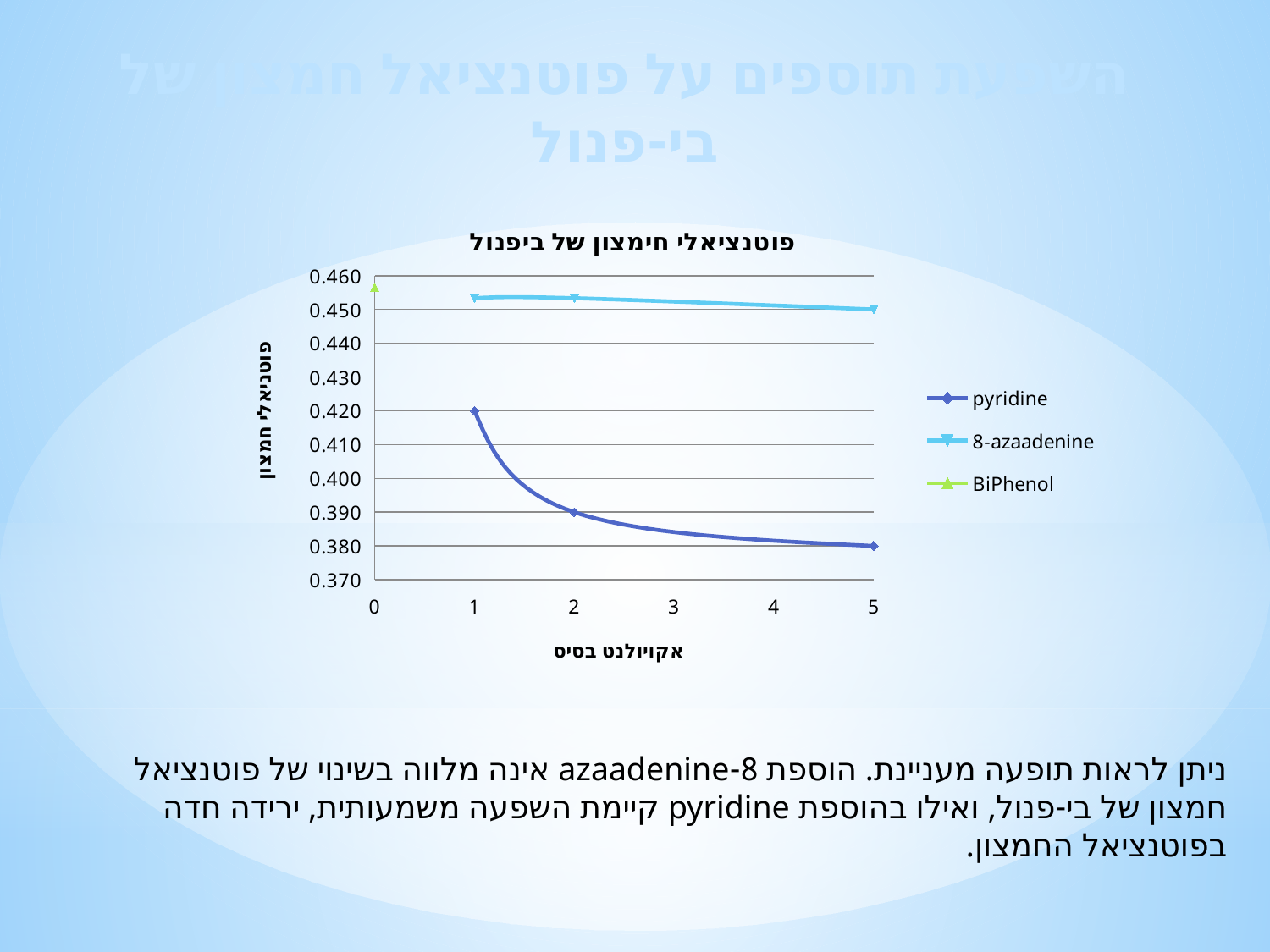
What kind of chart is shown on the slide? line chart What is the value of the pyridine series at x = 5? 0.380 What is the label of the x axis? אקויולנט בסיס Does the pyridine series rise or fall as x increases? fall Is the value of the pyridine series at x = 5 greater or less than 0.400? less What is the value of the pyridine series at x = 1? 0.420 Is the value of the BiPhenol point greater or less than 0.450? greater What is the title of the chart? פוטנציאלי חימצון של ביפנול Is the value of the 8-azaadenine series at x = 1 greater or less than 0.450? greater How many series does the legend list? 3 What is the value of the pyridine series at x = 2? 0.390 At x = 2, which series has the higher value, pyridine or 8-azaadenine? 8-azaadenine